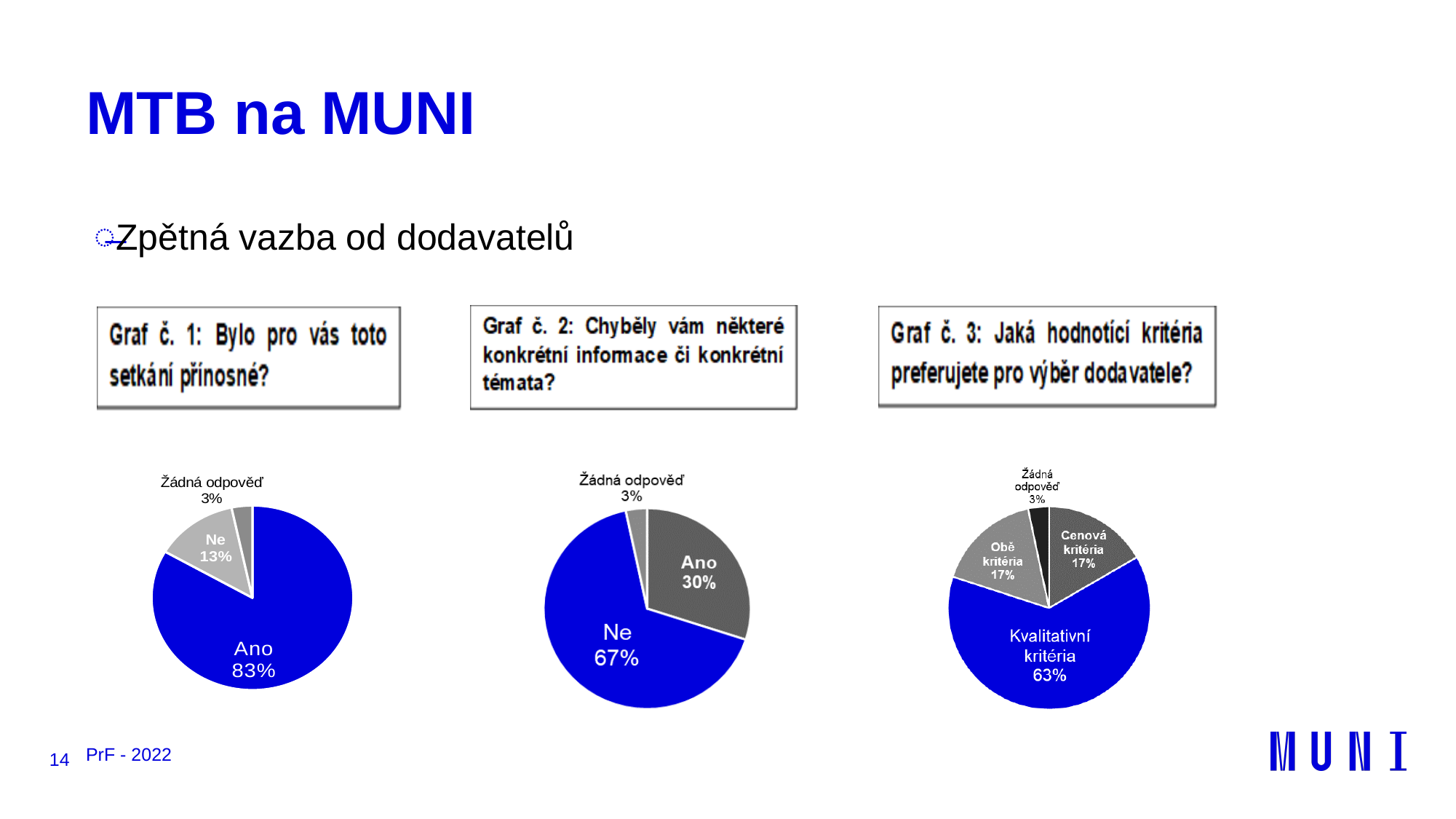
In Graf č. 1 (left chart), which slice is the largest? Ano In Graf č. 3 (right chart), what share of respondents prefer "Cenová kritéria"? 17% In Graf č. 3 (right chart), how many slices does the pie have? 4 In Graf č. 2 (middle chart), what is the difference in percentage points between "Ne" and "Ano"? 37 In Graf č. 2 (middle chart), which slice is the smallest? Žádná odpověď In Graf č. 1 (left chart), how many slices does the pie have? 3 In Graf č. 2 (middle chart), what share of respondents answered "Ne"? 67% In Graf č. 2 (middle chart), what share of respondents answered "Ano"? 30% In Graf č. 1 (left chart), what share of respondents answered "Ano"? 83% In Graf č. 1 (left chart), what share of respondents answered "Ne"? 13% In Graf č. 3 (right chart), what share of respondents prefer "Kvalitativní kritéria"? 63% What type of chart is used for Graf č. 1, Graf č. 2 and Graf č. 3? Pie chart